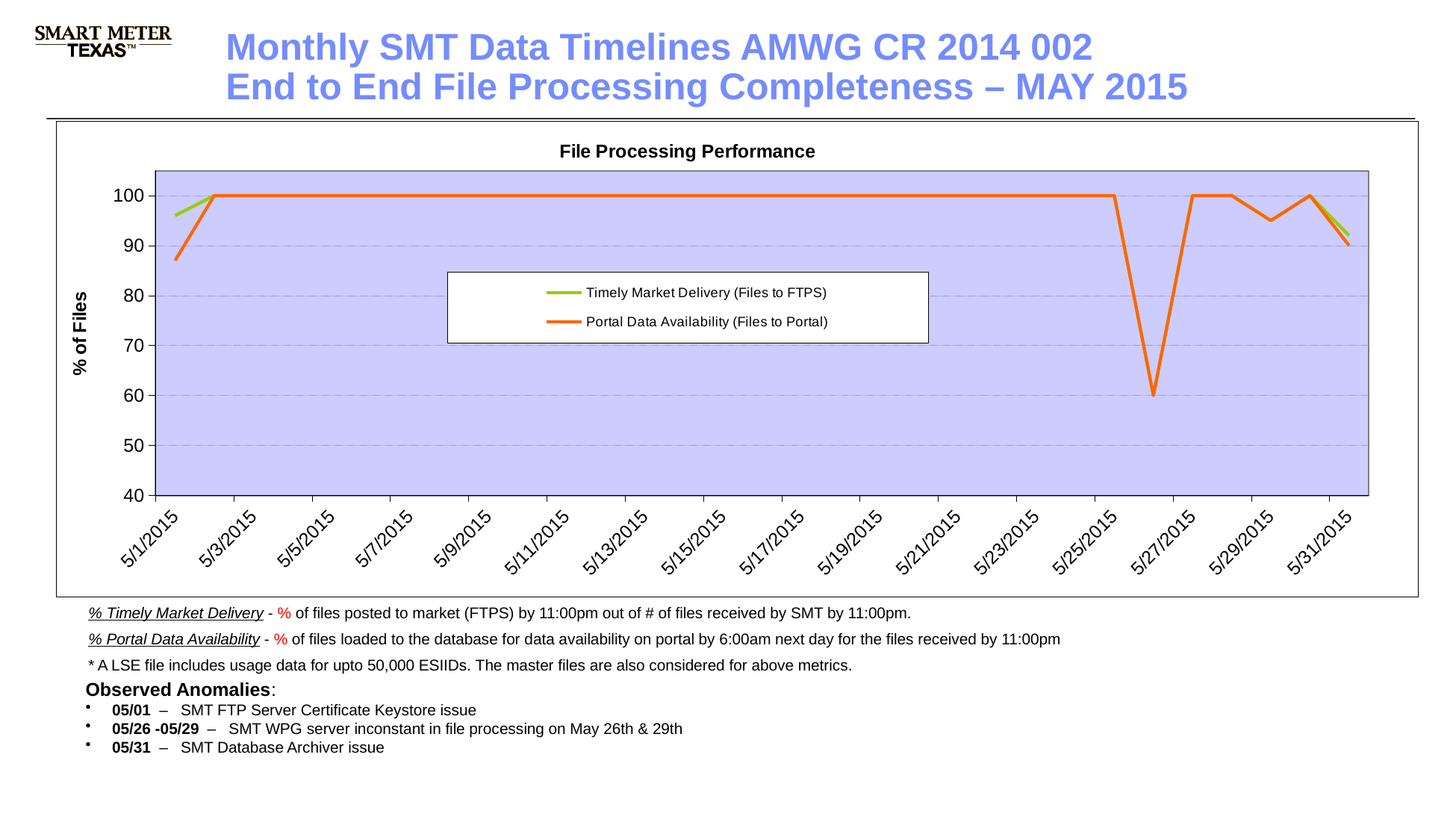
Between which two labeled dates does the Portal Data Availability (Files to Portal) line reach its lowest point? 5/25/2015 and 5/27/2015 What is the title of the chart? File Processing Performance Is the Portal Data Availability (Files to Portal) value on 5/15/2015 greater or less than 90? greater What is the label on the y-axis of the chart? % of Files What is the Portal Data Availability (Files to Portal) value on 5/15/2015? 100 Does the Portal Data Availability (Files to Portal) line rise or fall between 5/1/2015 and 5/3/2015? rise Is the Portal Data Availability (Files to Portal) value at its lowest point, between 5/25/2015 and 5/27/2015, greater or less than 70? less What type of chart is shown on the slide? line chart Is the Portal Data Availability (Files to Portal) value on 5/1/2015 greater or less than 90? less How many series does the chart legend list? 2 On 5/1/2015, which series has the higher value: Timely Market Delivery (Files to FTPS) or Portal Data Availability (Files to Portal)? Timely Market Delivery (Files to FTPS)